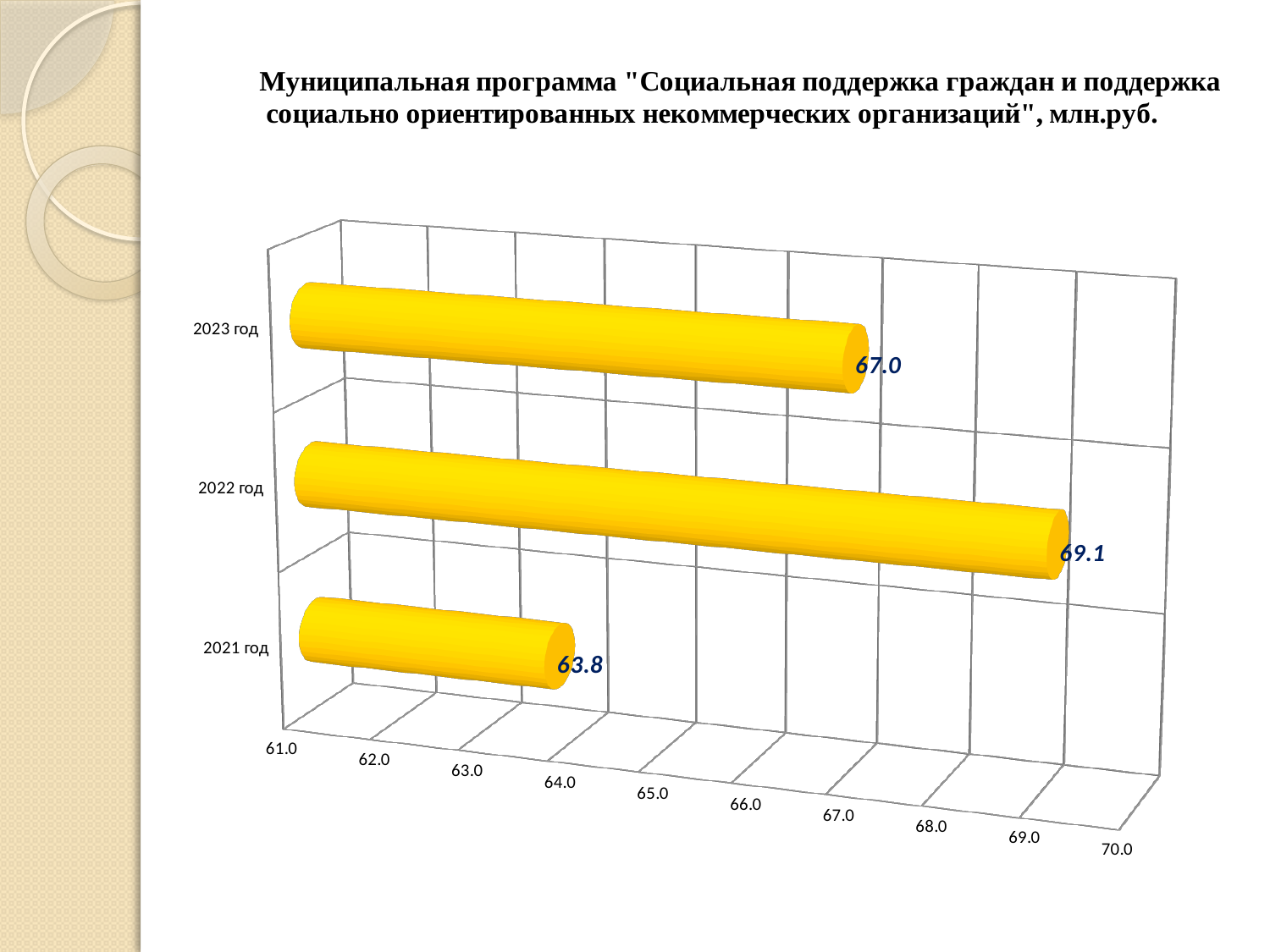
Which year has the lowest value? 2021 год What is the value for 2023 год? 67.0 Which is larger, the value for 2023 год or the value for 2021 год? 2023 год What is the value for 2021 год? 63.8 What is the difference between the values for 2022 год and 2021 год? 5.3 What is the difference between the values for 2022 год and 2023 год? 2.1 What is the value for 2022 год? 69.1 Which year has the highest value? 2022 год Is the value for 2021 год greater or less than 65.0? less What kind of chart is shown on the slide? bar chart What unit is stated in the chart title? млн.руб. How many categories (years) are shown in the chart? 3